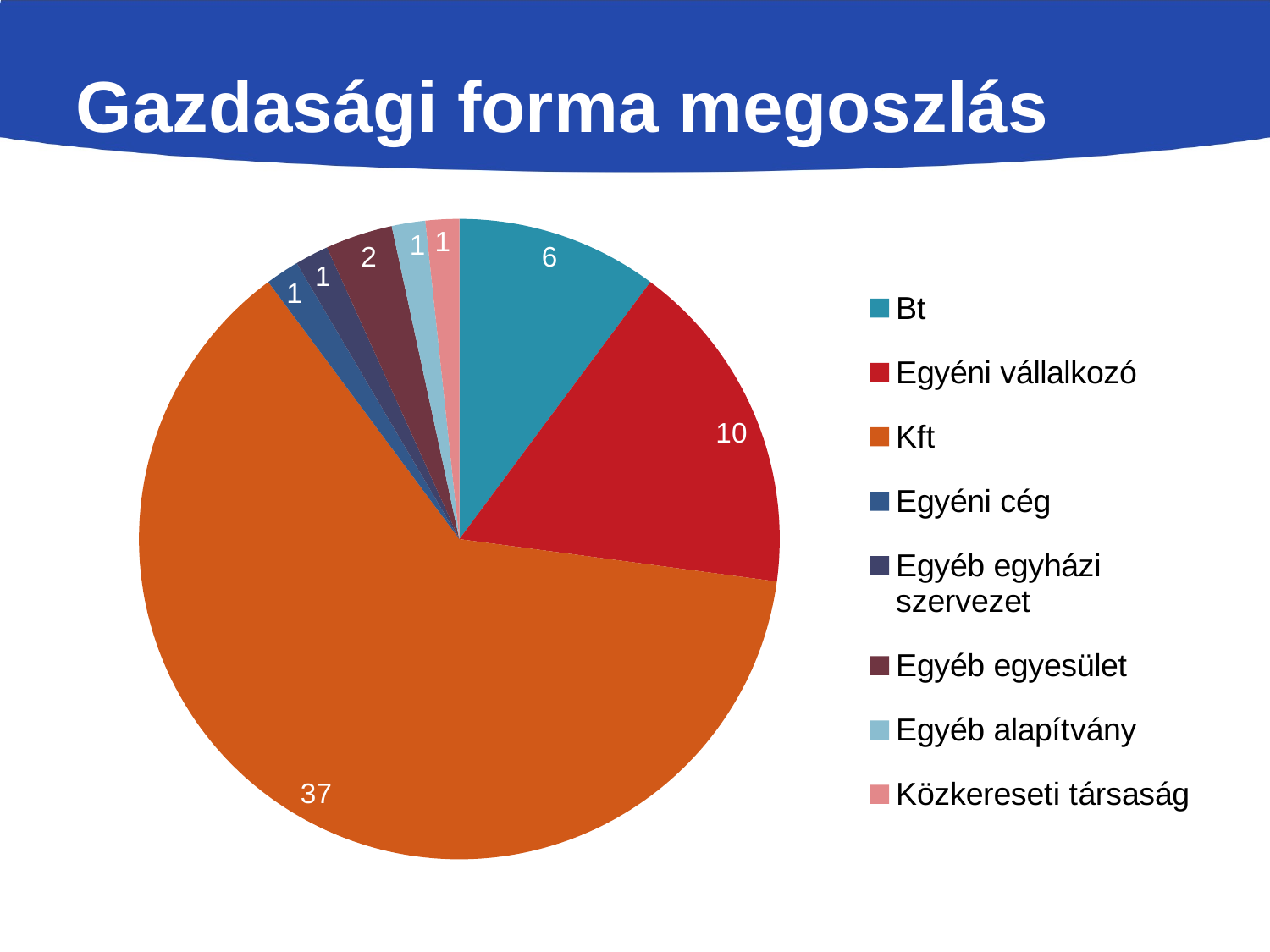
What is the value for Egyéni cég in the pie chart? 1 What is the value for Kft in the pie chart? 37 What type of chart is shown on the slide? pie chart What is the value for Egyéb egyesület in the pie chart? 2 What is the value for Egyéni vállalkozó in the pie chart? 10 Which category has the largest slice in the pie chart? Kft What is the value for Bt in the pie chart? 6 How many categories does the legend of the pie chart list? 8 What colour is the Kft slice in the pie chart? orange Which is larger in the pie chart, Bt or Egyéni vállalkozó? Egyéni vállalkozó What is the title of the chart on the slide? Gazdasági forma megoszlás What is the difference between the values for Kft and Egyéni vállalkozó? 27